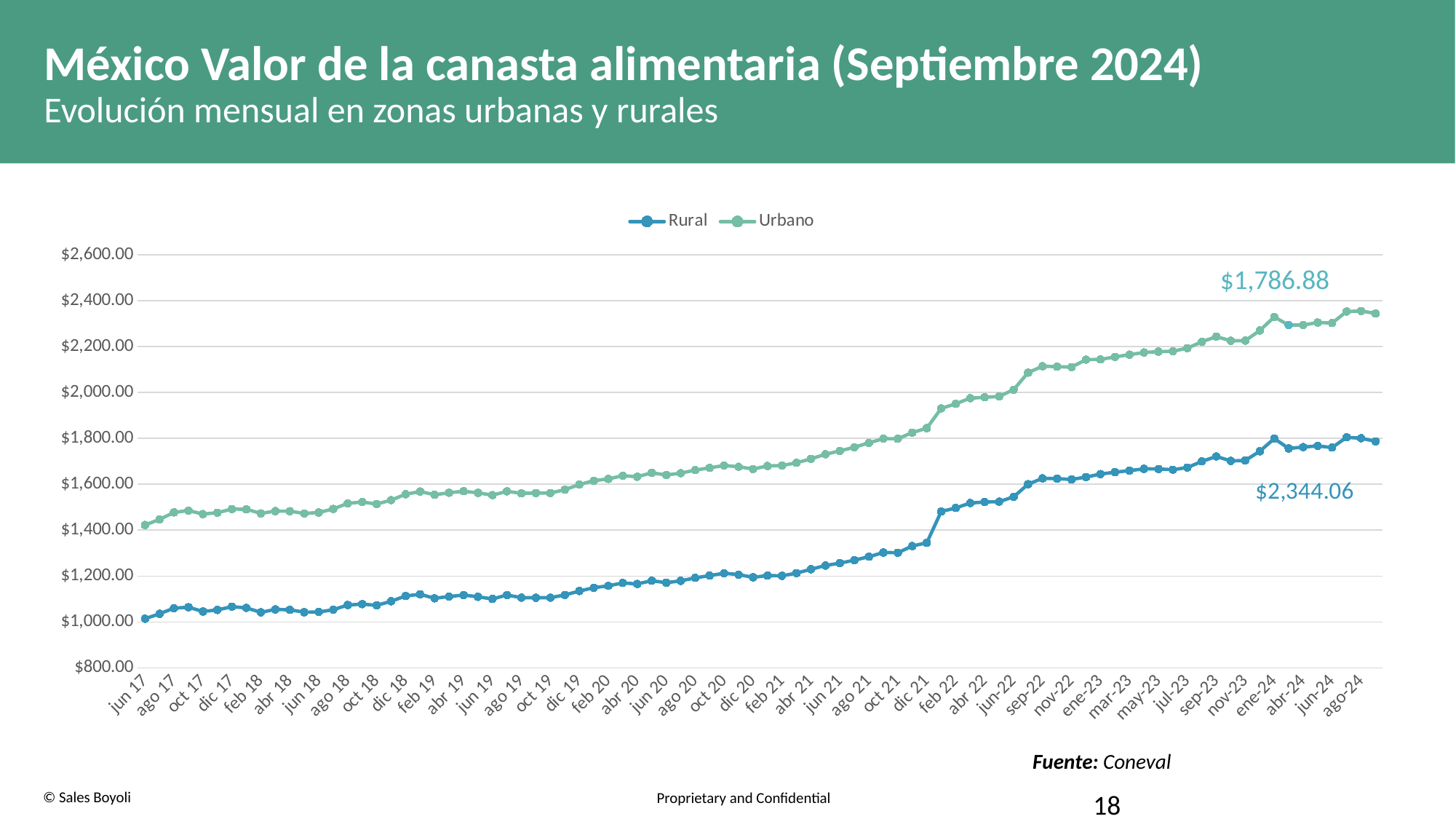
What kind of chart is shown on the slide? line chart Which series has the higher value in ago-24, Rural or Urbano? Urbano Is the Rural value for jun 17 greater or less than $1,200.00? less Do the Rural values rise or fall from jun 17 to ago-24? rise What is the title of the slide containing the chart? México Valor de la canasta alimentaria (Septiembre 2024) What are the two series named in the legend? Rural and Urbano Which series is higher across the whole period shown? Urbano Is the Urbano value for jun 17 greater or less than $1,600.00? less How many series does the legend list? 2 Is the Urbano value for ago-24 greater or less than $2,200.00? greater Which of the two data labels printed on the chart is the larger value? $2,344.06